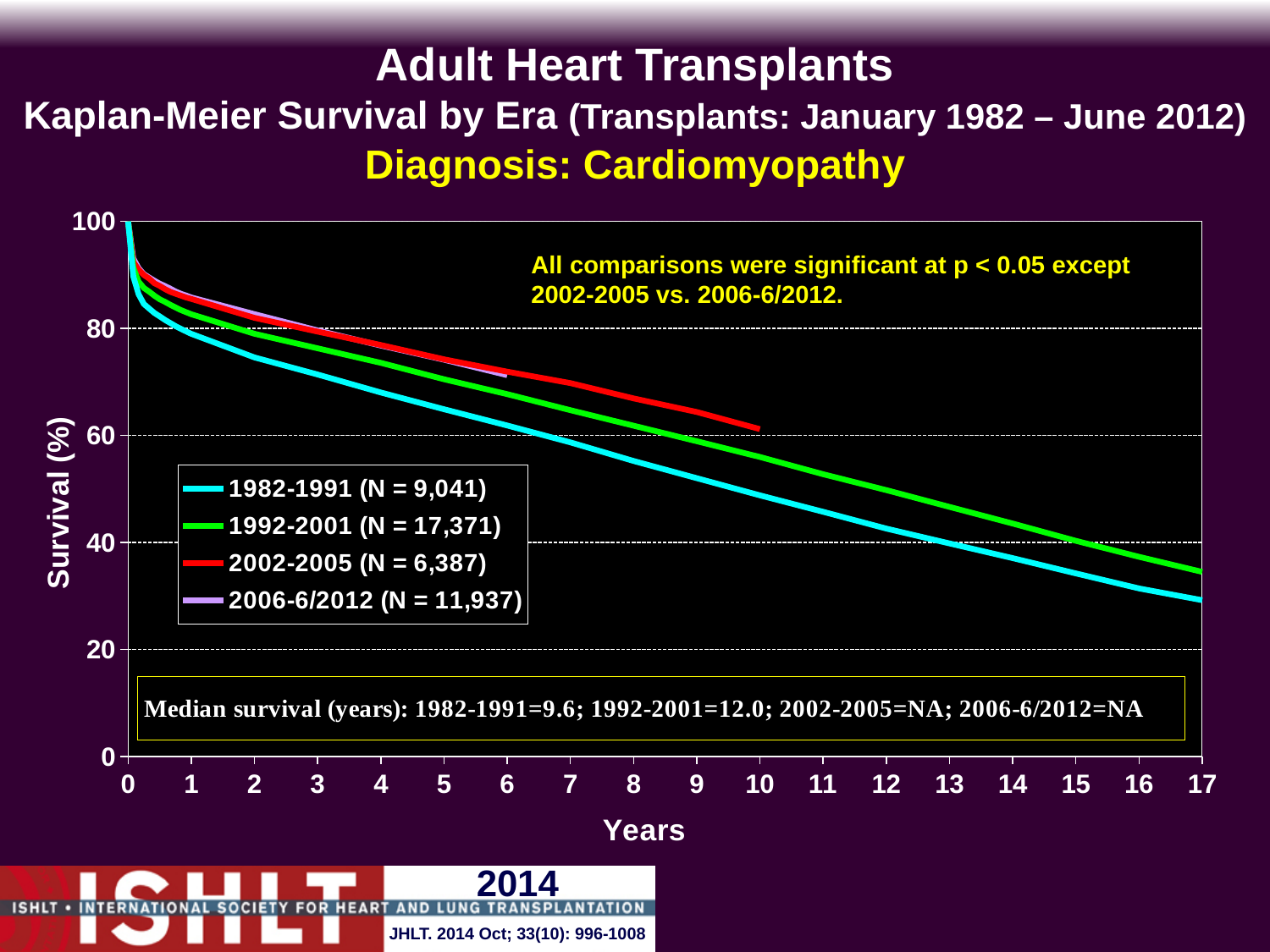
Which era has the lowest survival curve across the chart? 1982-1991 How many eras (series) does the legend list? 4 At 10 years, which era has higher survival: 1982-1991 or 1992-2001? 1992-2001 At 10 years, is survival for the 1982-1991 era greater or less than 60%? less What kind of chart is shown on the slide? line chart At 17 years, is survival for the 1992-2001 era greater or less than 40%? less What is the median survival in years for the 1992-2001 era? 12.0 What is the number of transplants (N) for the 1992-2001 era? 17,371 Which era has the largest N in the legend? 1992-2001 What is the difference in N between the 1992-2001 era and the 1982-1991 era? 8,330 Do the survival curves rise or fall as years increase? fall What is the median survival in years for the 1982-1991 era? 9.6